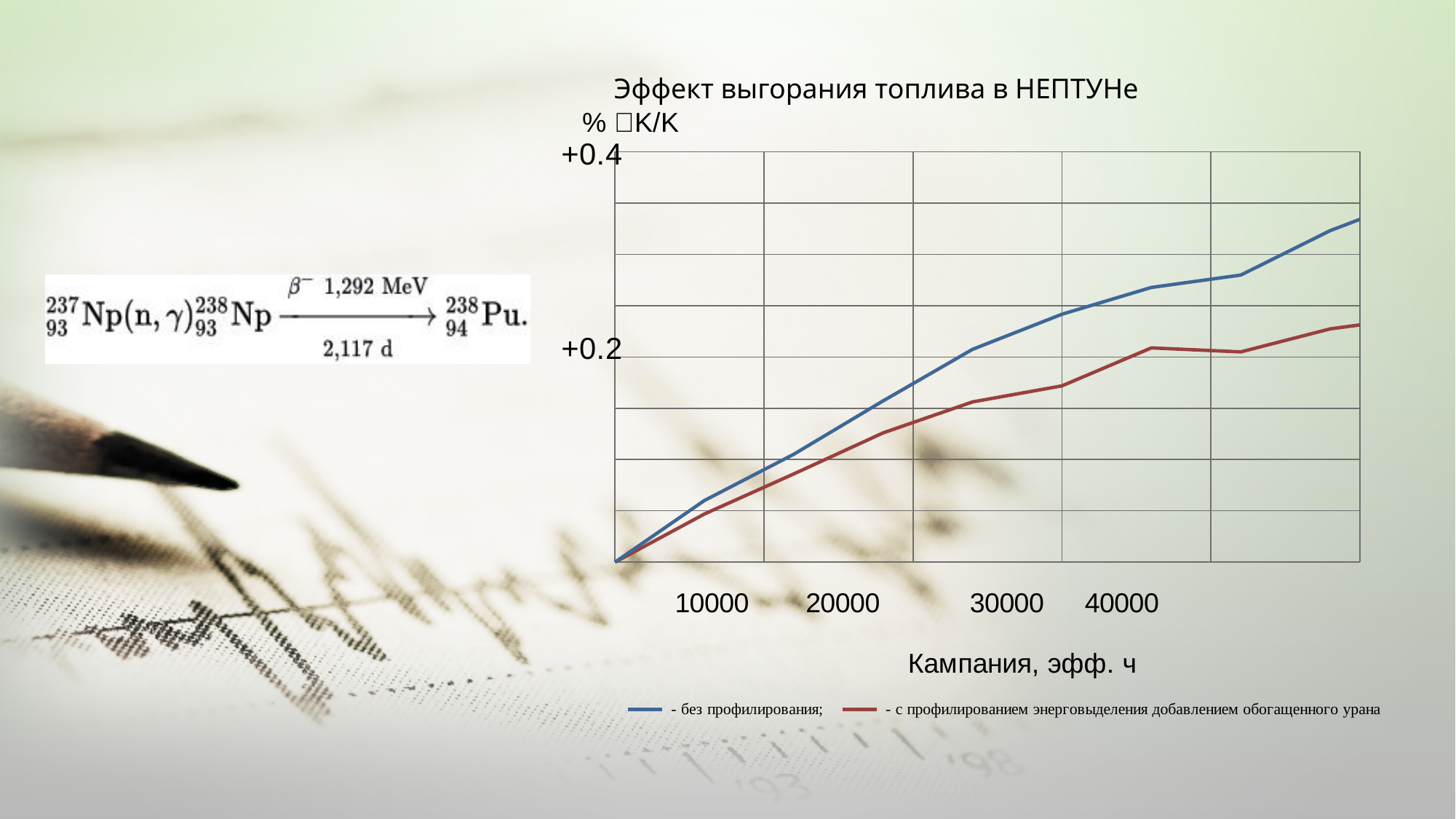
What is the title of the chart? Эффект выгорания топлива в НЕПТУНе Is the highest value reached by the 'без профилирования' series greater or less than +0.4? less Is the value of the 'без профилирования' series at 10000 эфф. ч greater or less than +0.2? less What kind of chart is shown on the slide? line chart What is the label of the x axis? Кампания, эфф. ч At 40000 эфф. ч, which series has the larger value: 'без профилирования' or 'с профилированием энерговыделения добавлением обогащенного урана'? без профилирования Which series is drawn in blue? без профилирования How many series does the legend list? 2 Is the value of the 'без профилирования' series at 40000 эфф. ч greater or less than +0.2? greater Do the values of the 'без профилирования' series rise or fall along the x axis? rise Do the values of the 'с профилированием энерговыделения добавлением обогащенного урана' series generally rise or fall along the x axis? rise